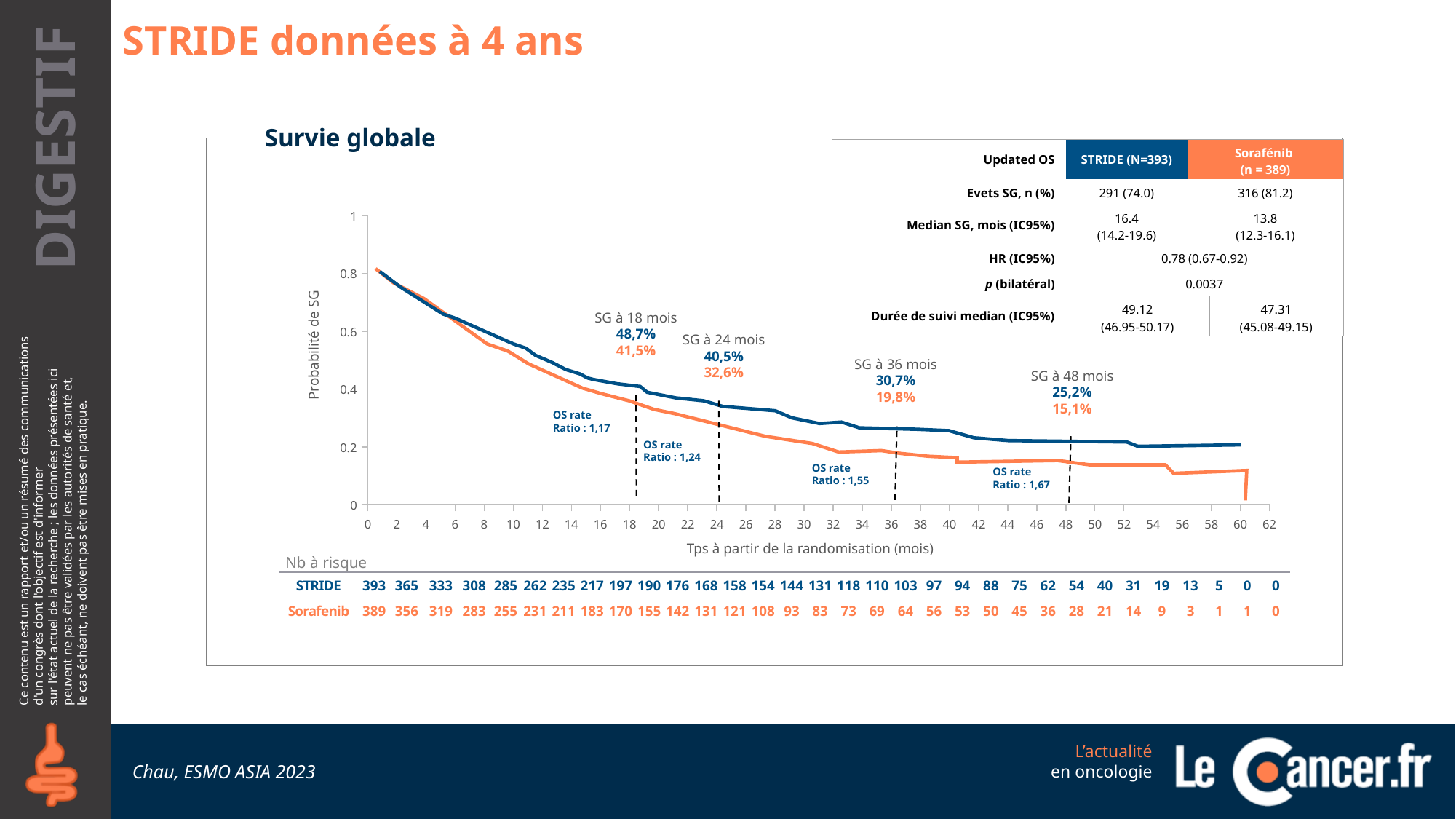
Is the STRIDE curve at 12 months greater or less than 0.4? greater Which curve is higher at 36 months, STRIDE or Sorafenib? STRIDE What is the overall survival (SG) rate at 24 months for Sorafenib? 32,6% What is the OS rate ratio shown at 24 months? 1,24 What is the label of the y axis of the survival chart? Probabilité de SG What kind of chart is shown under the title 'Survie globale'? line chart What is the overall survival (SG) rate at 48 months for STRIDE? 25,2% How many Sorafenib patients are at risk at 24 months? 121 At which time point is the OS rate ratio the highest? 48 mois (1,67) What is the difference between the STRIDE and Sorafenib survival rates at 36 months? 10,9 points What is the overall survival (SG) rate at 18 months for STRIDE? 48,7% Do the survival curves rise or fall as time from randomisation increases? fall